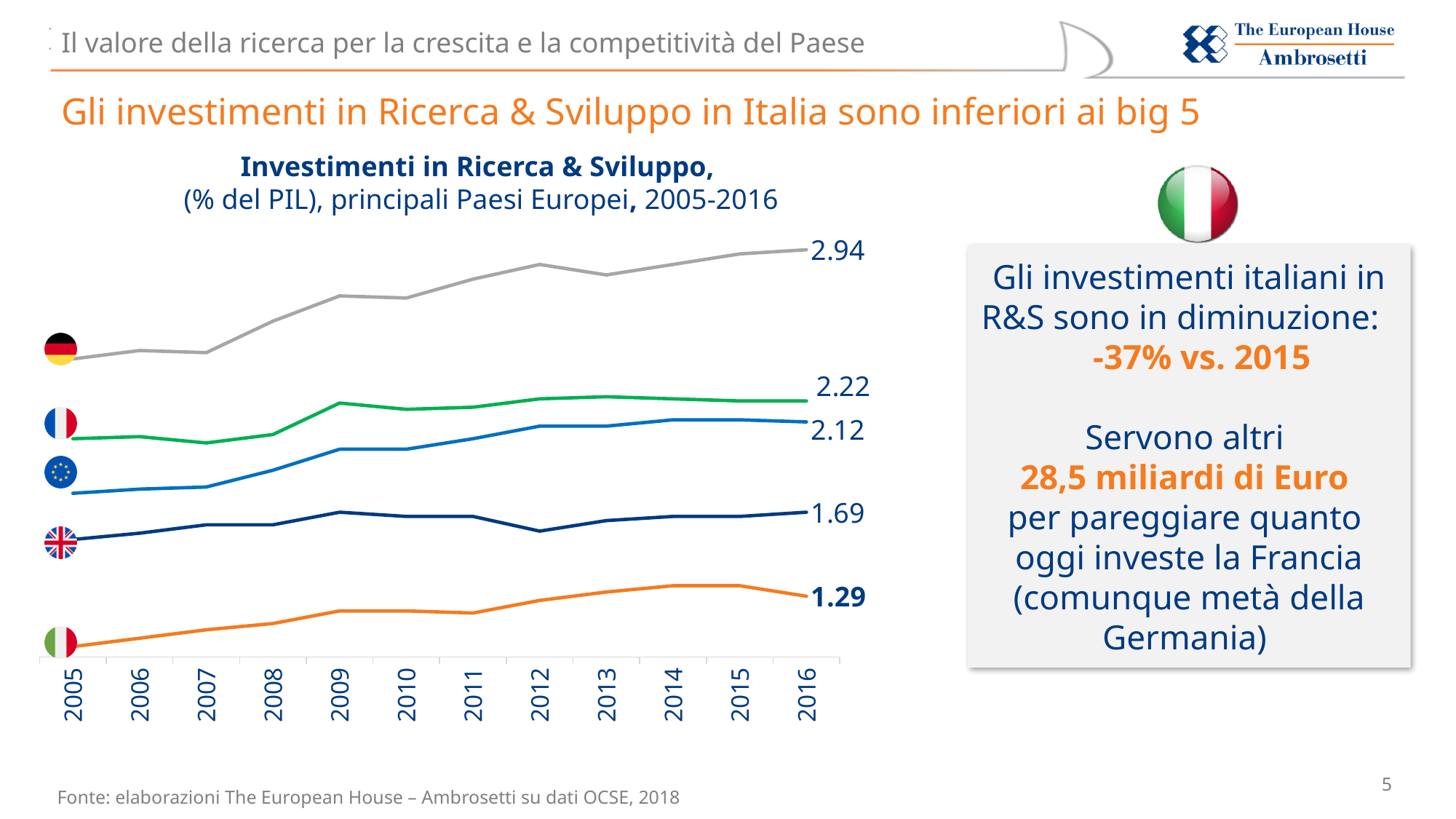
How many years are shown on the x axis of the chart? 12 What is the difference between the 2016 values of the German line and the Italian line? 1.65 What kind of chart is shown on the slide? Line chart Does the line marked with the German flag rise or fall from 2005 to 2016? Rises Which line has the highest value in 2016? Germany (2.94) What is the 2016 value for the line marked with the EU flag? 2.12 What is the 2016 value for the line marked with the German flag? 2.94 What is the 2016 value for the line marked with the French flag? 2.22 What is the 2016 value for the line marked with the UK flag? 1.69 How many lines (countries/regions) are plotted in the chart? 5 What is the 2016 value for the line marked with the Italian flag? 1.29 Which line has the lowest value in 2016? Italy (1.29)